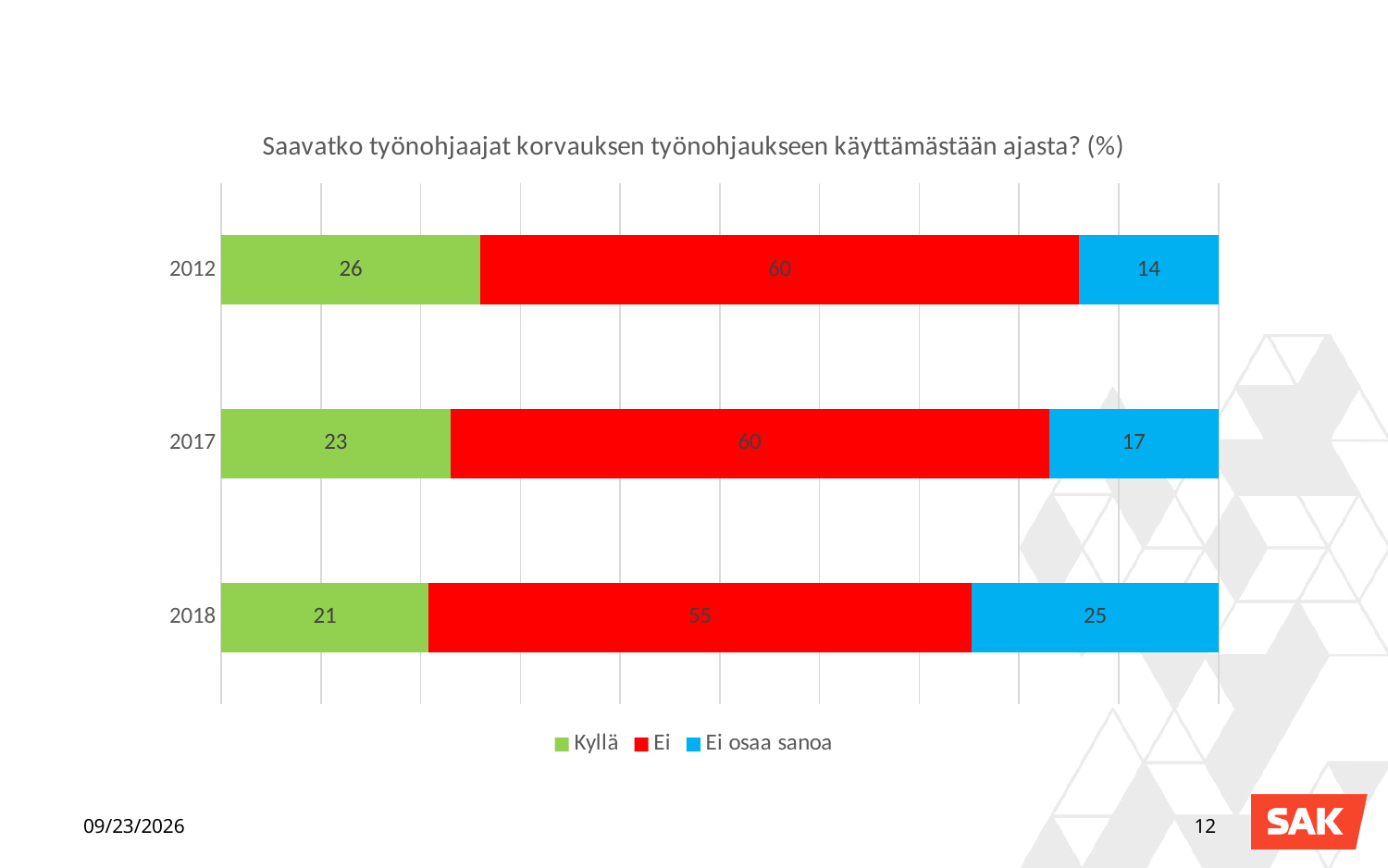
How many years are shown on the chart? 3 What is the difference between the "Ei osaa sanoa" values for 2018 and 2012? 11 Which year has the lowest value for "Kyllä"? 2018 What kind of chart is shown on the slide? Stacked bar chart What is the value for "Ei osaa sanoa" in 2018? 25 Which is larger: the "Kyllä" value for 2012 or for 2017? 2012 What is the value for "Kyllä" in 2012? 26 How many series does the legend list? 3 Which colour represents the "Ei" series? Red Which year has the highest value for "Ei osaa sanoa"? 2018 What is the total of the stacked bar for 2017? 100 What is the value for "Ei" in 2017? 60